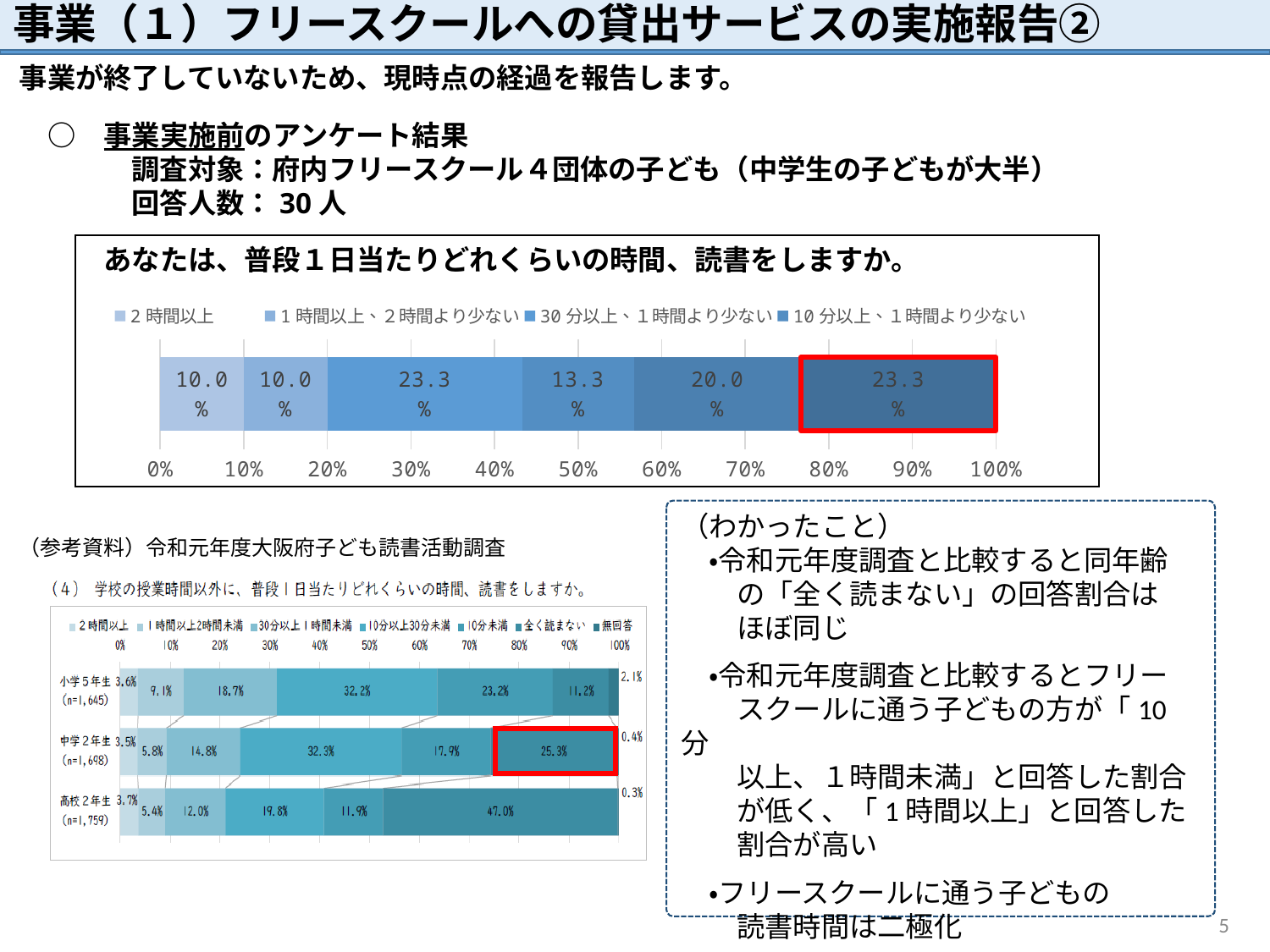
In the bottom chart (令和元年度大阪府子ども読書活動調査), what is the 「全く読まない」 value for 中学２年生? 25.3% What kind of chart is the top chart titled 「あなたは、普段１日当たりどれくらいの時間、読書をしますか。」? Stacked bar chart In the top chart (free school survey), what value is shown in the segment outlined in red? 23.3% In the bottom chart (令和元年度大阪府子ども読書活動調査), what is the 「全く読まない」 value for 高校２年生? 47.0% How many series does the legend of the bottom chart (令和元年度大阪府子ども読書活動調査) list? 7 In the bottom chart (令和元年度大阪府子ども読書活動調査), which grade has the highest 「全く読まない」 share? 高校２年生 In the bottom chart (令和元年度大阪府子ども読書活動調査), does the 「全く読まない」 share rise or fall from 小学５年生 to 高校２年生? Rises How many grade categories are shown in the bottom chart (令和元年度大阪府子ども読書活動調査)? 3 In the top chart (free school survey), what is the value of the segment for 「30分以上、１時間より少ない」? 23.3% In the bottom chart (令和元年度大阪府子ども読書活動調査), what is the difference between the 「全く読まない」 values for 高校２年生 and 小学５年生? 35.8% How many segments make up the bar in the top chart (free school survey)? 6 In the top chart (free school survey), what is the value of the first segment, 「２時間以上」? 10.0%